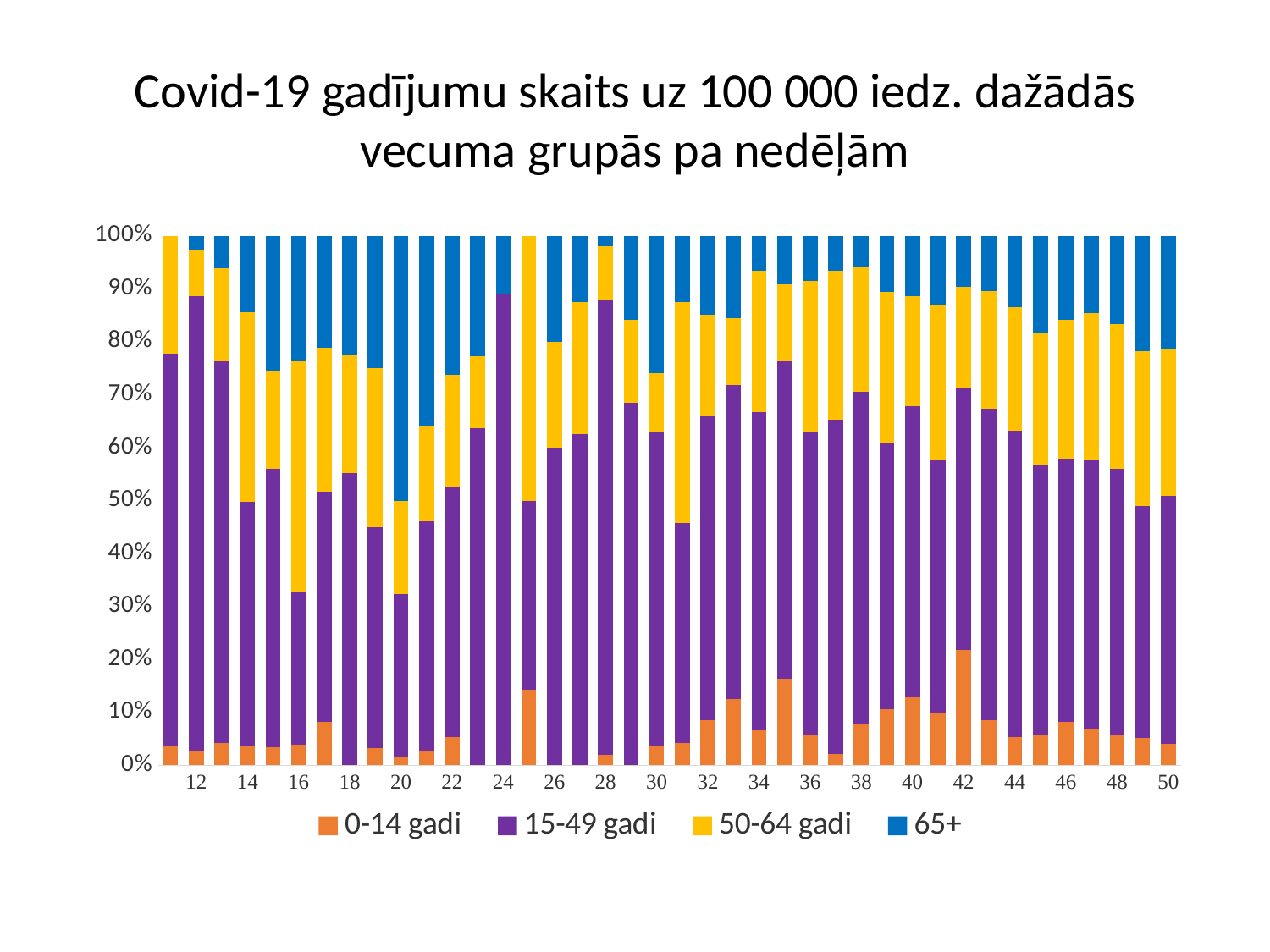
How many series does the legend list? 4 Is the share of the 0-14 gadi group in week 42 greater or less than 20%? greater Is the share of the 15-49 gadi group in week 24 greater or less than 80%? greater What is the title of the chart? Covid-19 gadījumu skaits uz 100 000 iedz. dažādās vecuma grupās pa nedēļām Which has the larger 65+ share, week 20 or week 21? Week 20 Is the share of the 65+ group in week 12 greater or less than 10%? less What is the maximum value shown on the vertical axis? 100% Which week has the largest share for the 0-14 gadi group? 42 What kind of chart is shown on the slide? Stacked bar chart What are the four age groups listed in the legend? 0-14 gadi, 15-49 gadi, 50-64 gadi, 65+